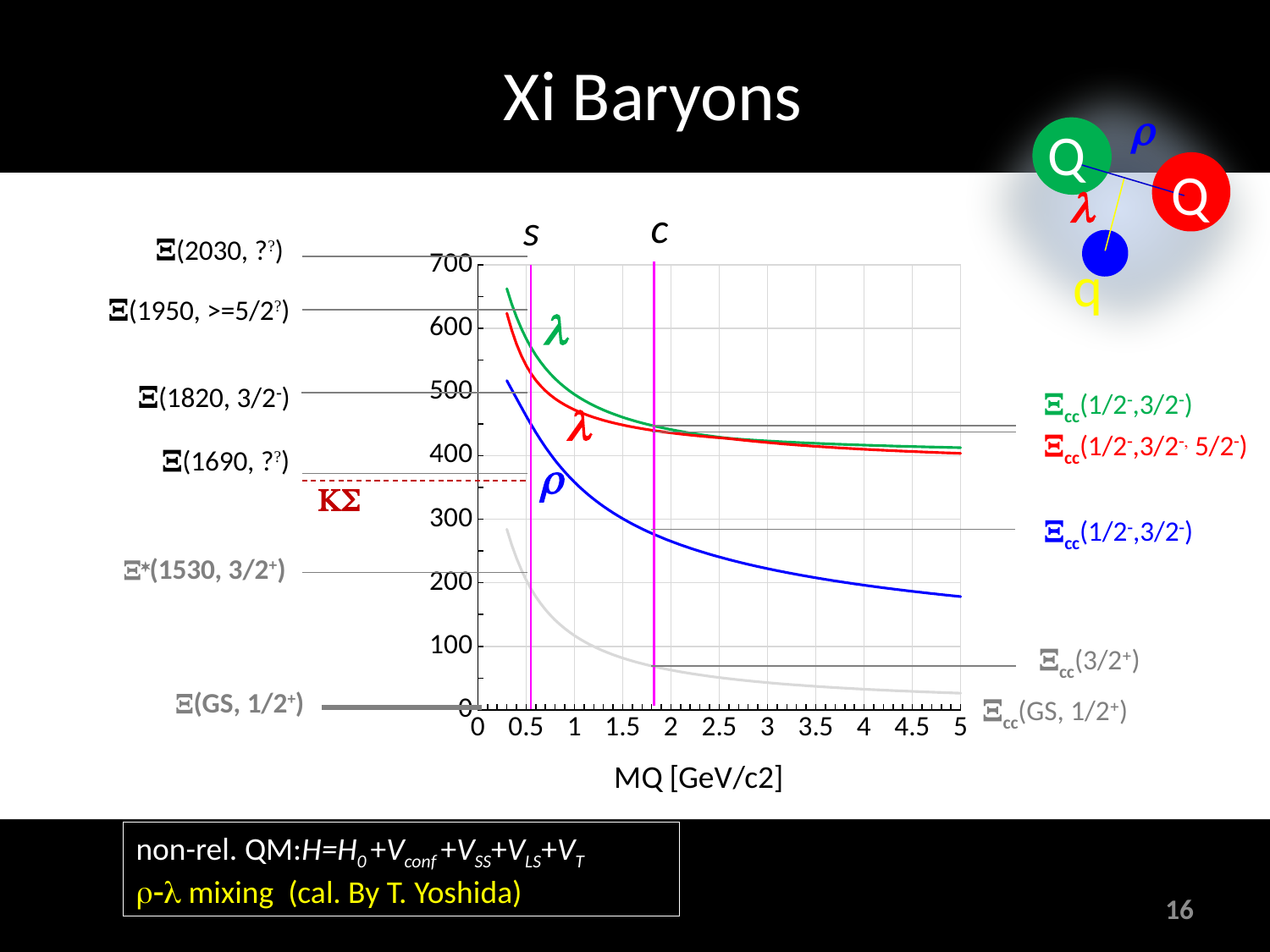
What is the label of the x axis of the chart? MQ [GeV/c2] At MQ = 5, which curve has the larger value, the green λ curve or the blue ρ curve? green λ curve Do the plotted curves rise or fall as MQ increases? fall Which curve has the lowest values across the whole MQ range? the light gray curve What kind of chart is shown on the slide? line chart Is the value of the red λ curve at the vertical line marked c greater or less than 400? greater Which curve has the highest value at the vertical line marked s? the green λ curve Is the value of the green λ curve at MQ = 5 greater or less than 400? greater Is the value of the light gray curve at MQ = 5 greater or less than 100? less How many curves are plotted on the chart? 4